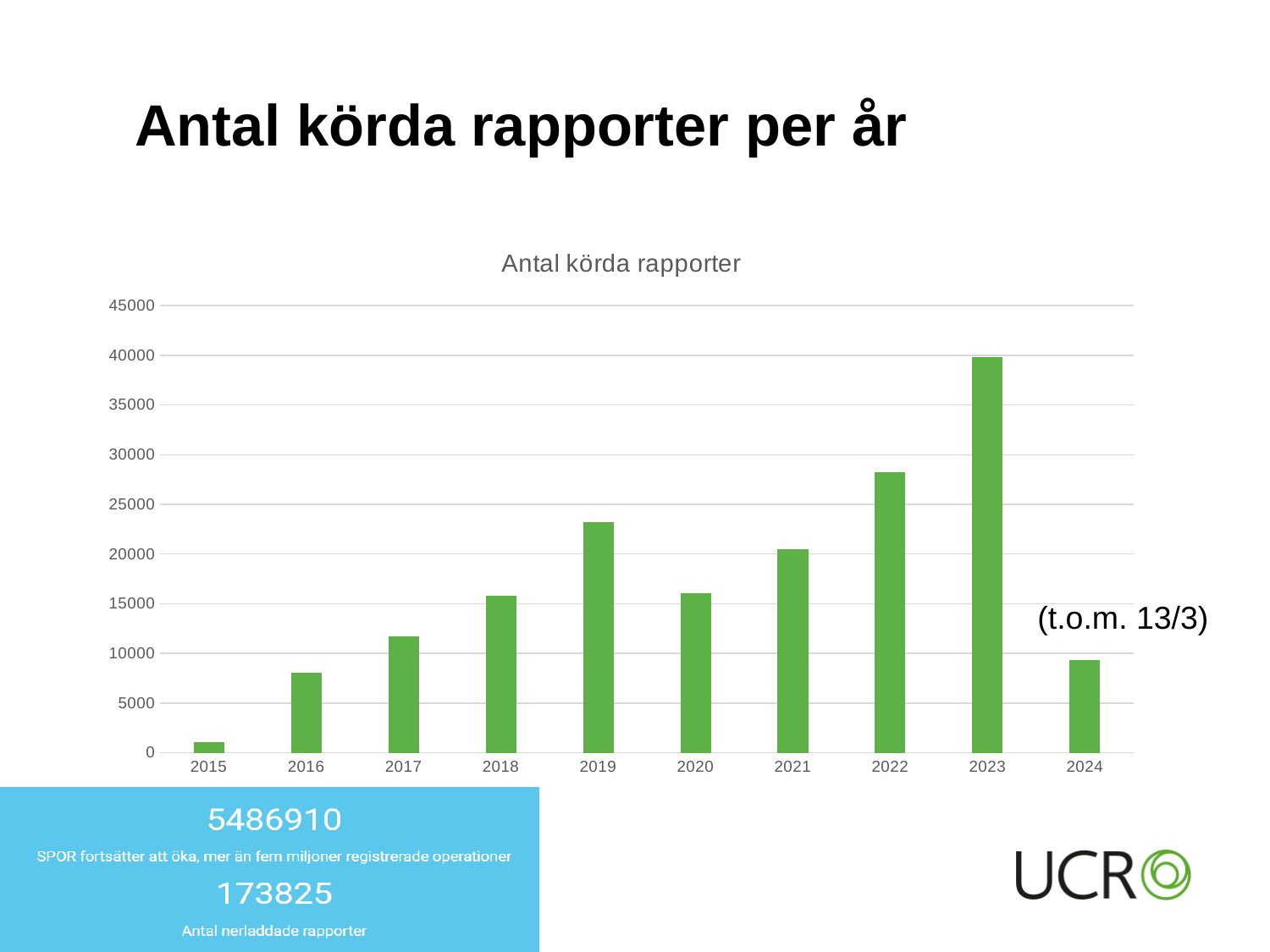
Is the value for 2015 greater or less than 5000? less What is the title shown above the chart? Antal körda rapporter Which year has a higher value, 2021 or 2022? 2022 Is the value for 2020 greater or less than 20000? less Which year has a higher value, 2019 or 2020? 2019 Is the value for 2019 greater or less than 20000? greater What kind of chart is shown on the slide? Bar chart Which year has the lowest number of run reports? 2015 Which year has the highest number of run reports (Antal körda rapporter)? 2023 How many years are shown on the x axis of the chart? 10